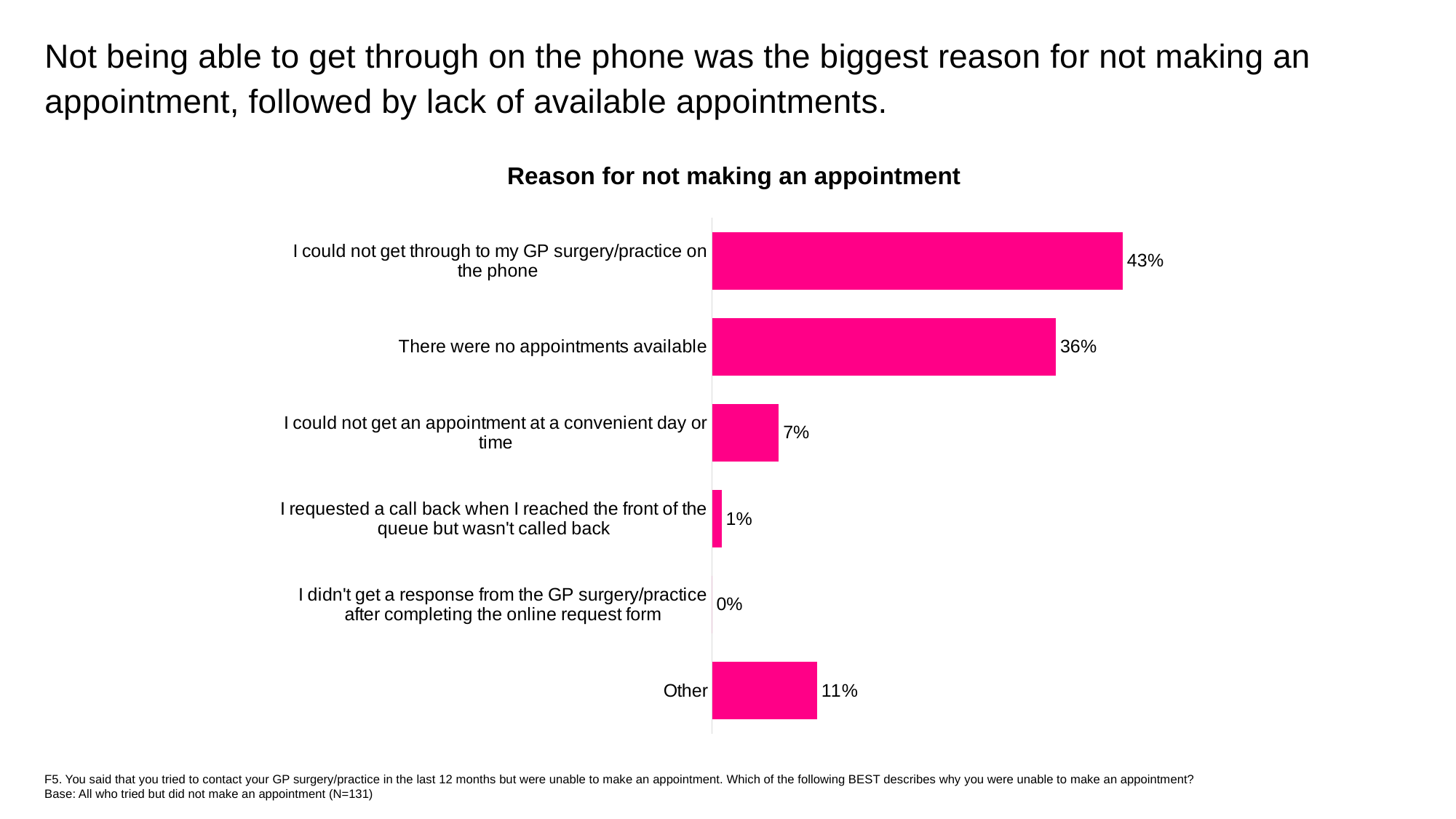
What is the title of the chart? Reason for not making an appointment Which reason has the lowest value? I didn't get a response from the GP surgery/practice after completing the online request form What is the difference between the value for not getting through on the phone and the value for no appointments available? 7 percentage points Which is larger: the value for 'Other' or the value for 'I could not get an appointment at a convenient day or time'? Other How many reasons (categories) are shown in the chart? 6 What is the value for 'Other'? 11% Which reason has the highest value? I could not get through to my GP surgery/practice on the phone What is the value for 'There were no appointments available'? 36% What percentage said they didn't get a response from the GP surgery/practice after completing the online request form? 0% What percentage of respondents said they could not get through to their GP surgery/practice on the phone? 43% What percentage said they could not get an appointment at a convenient day or time? 7% What type of chart is shown on the slide? Bar chart